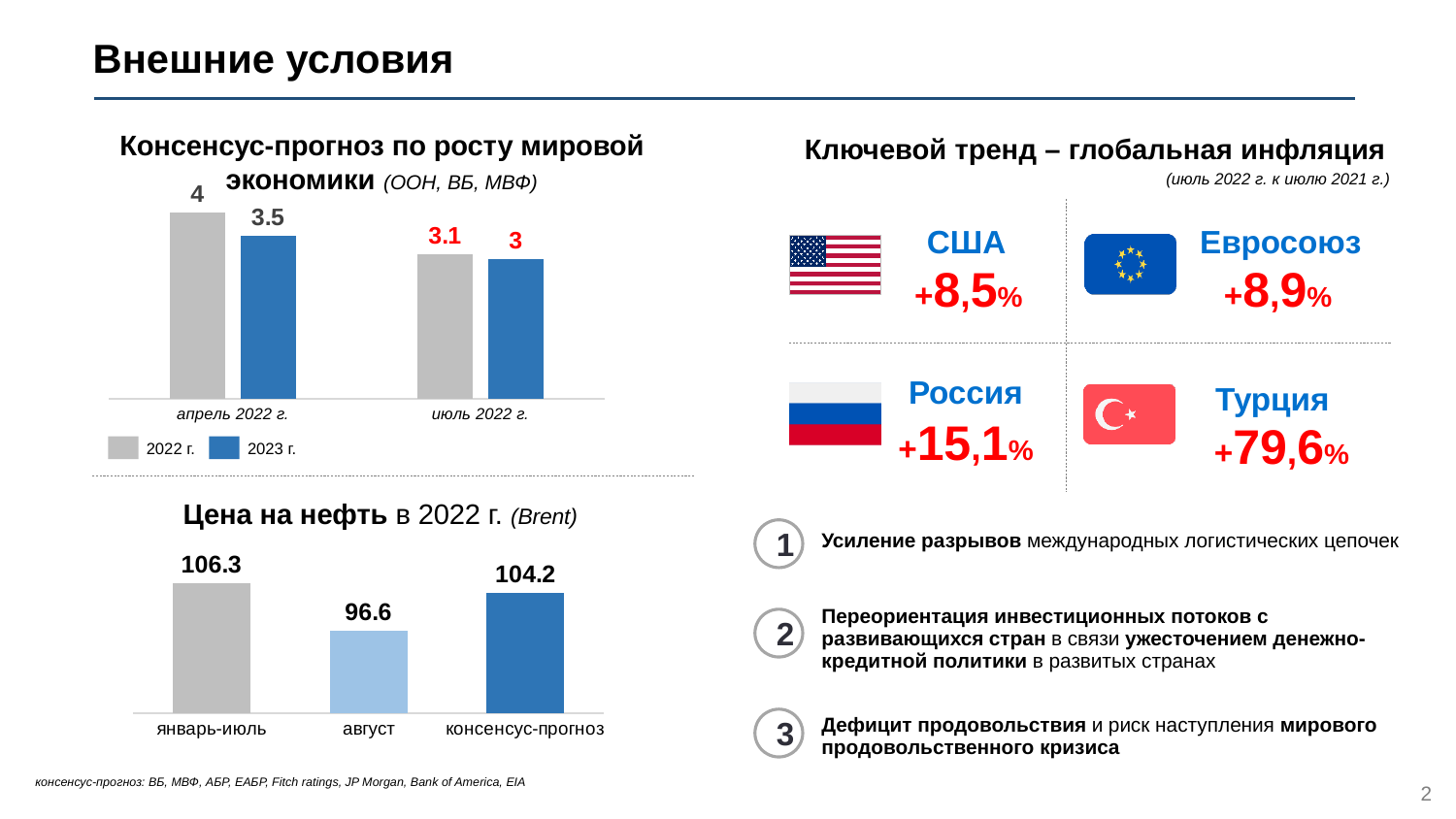
In the chart 'Консенсус-прогноз по росту мировой экономики', what is the difference between the 2022 г. and 2023 г. values in апрель 2022 г.? 0.5 In the chart 'Консенсус-прогноз по росту мировой экономики', what is the value for 2022 г. in июль 2022 г.? 3.1 In the chart 'Консенсус-прогноз по росту мировой экономики', how many series does the legend list? 2 In the chart 'Цена на нефть в 2022 г. (Brent)', which category has the lowest value? август In the chart 'Консенсус-прогноз по росту мировой экономики', what is the value for 2022 г. in апрель 2022 г.? 4 What kind of chart is 'Цена на нефть в 2022 г. (Brent)'? bar chart In the chart 'Цена на нефть в 2022 г. (Brent)', what is the value for август? 96.6 In the chart 'Цена на нефть в 2022 г. (Brent)', what is the difference between январь-июль and консенсус-прогноз? 2.1 In the chart 'Цена на нефть в 2022 г. (Brent)', which category has the highest value? январь-июль In the chart 'Консенсус-прогноз по росту мировой экономики', does the 2022 г. value rise or fall from апрель 2022 г. to июль 2022 г.? fall In the chart 'Консенсус-прогноз по росту мировой экономики', what is the value for 2023 г. in июль 2022 г.? 3 In the chart 'Цена на нефть в 2022 г. (Brent)', how many categories are shown? 3